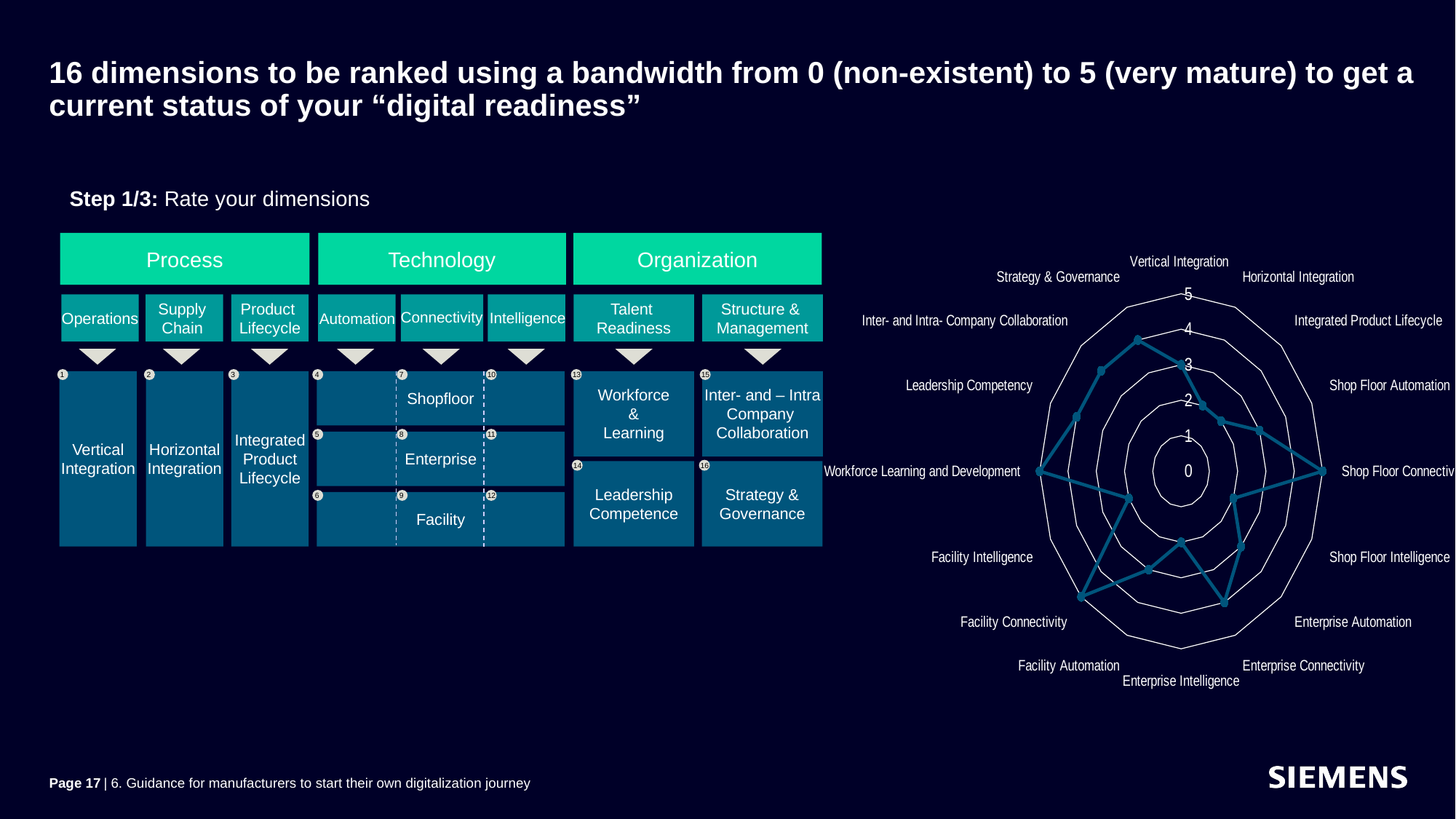
What kind of chart is shown on the right side of the slide? Radar chart Is the value for Workforce Learning and Development greater or less than 3? greater Is the value for Facility Connectivity greater or less than 3? greater How many dimensions (axes) does the radar chart have? 16 Is the value for Shop Floor Connectivity greater or less than 3? greater What is the highest value marked on the radar chart's scale? 5 Which dimension label sits at the top of the radar chart? Vertical Integration Which has the larger value on the radar chart, Shop Floor Connectivity or Shop Floor Intelligence? Shop Floor Connectivity Which has the larger value on the radar chart, Workforce Learning and Development or Enterprise Intelligence? Workforce Learning and Development